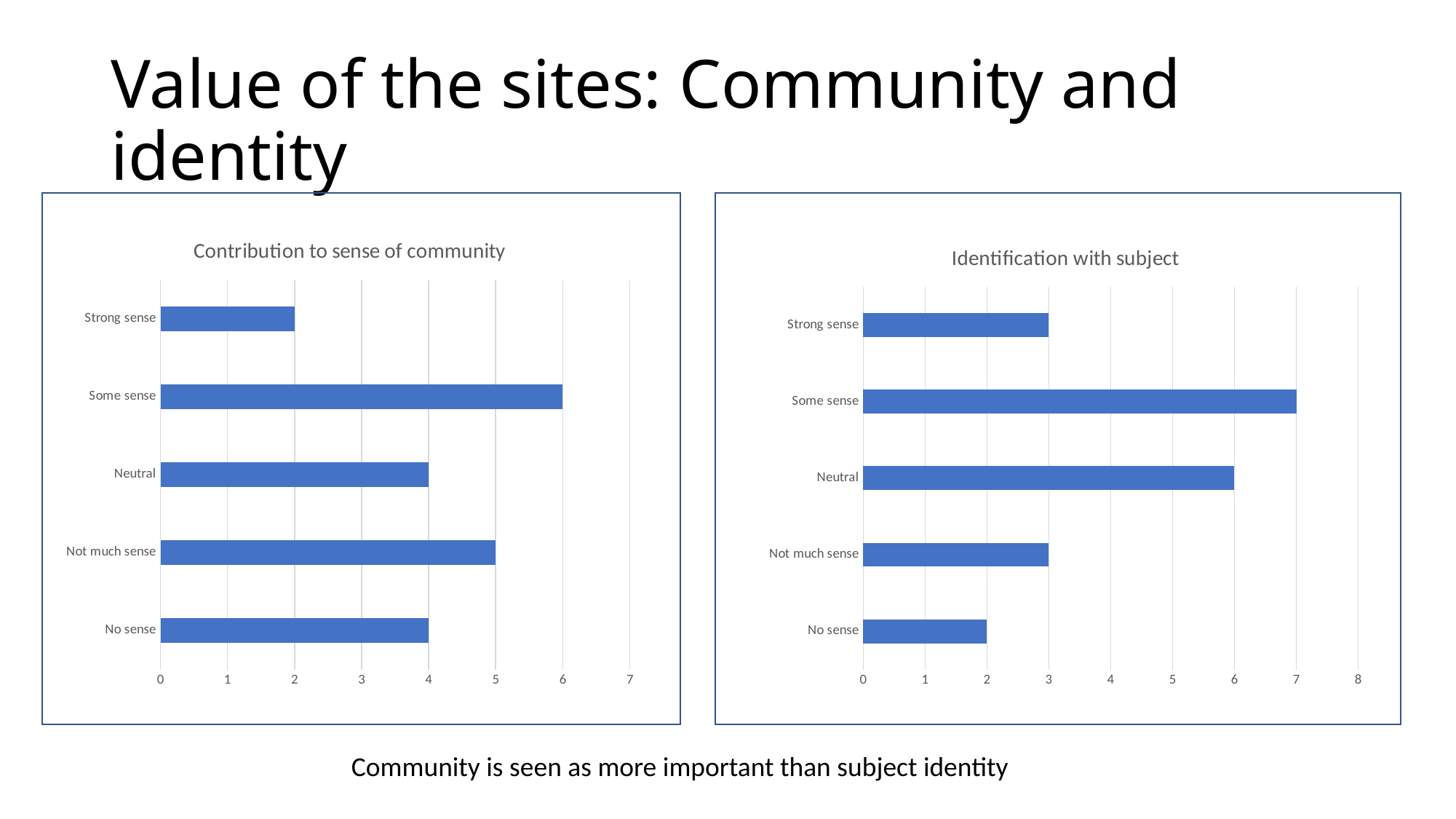
In the 'Identification with subject' chart, what is the value for Some sense? 7 In the 'Contribution to sense of community' chart, what is the value for Some sense? 6 What type of chart is the 'Identification with subject' chart? Bar chart In the 'Identification with subject' chart, what is the value for Neutral? 6 In the 'Contribution to sense of community' chart, what is the difference between Not much sense and Strong sense? 3 In the 'Contribution to sense of community' chart, which category has the lowest value? Strong sense In the 'Contribution to sense of community' chart, what is the value for Strong sense? 2 In the 'Identification with subject' chart, which is larger, Neutral or Not much sense? Neutral In the 'Identification with subject' chart, which category has the lowest value? No sense In the 'Identification with subject' chart, what is the difference between Some sense and No sense? 5 In the 'Contribution to sense of community' chart, which category has the highest value? Some sense How many categories are shown in the 'Contribution to sense of community' chart? 5